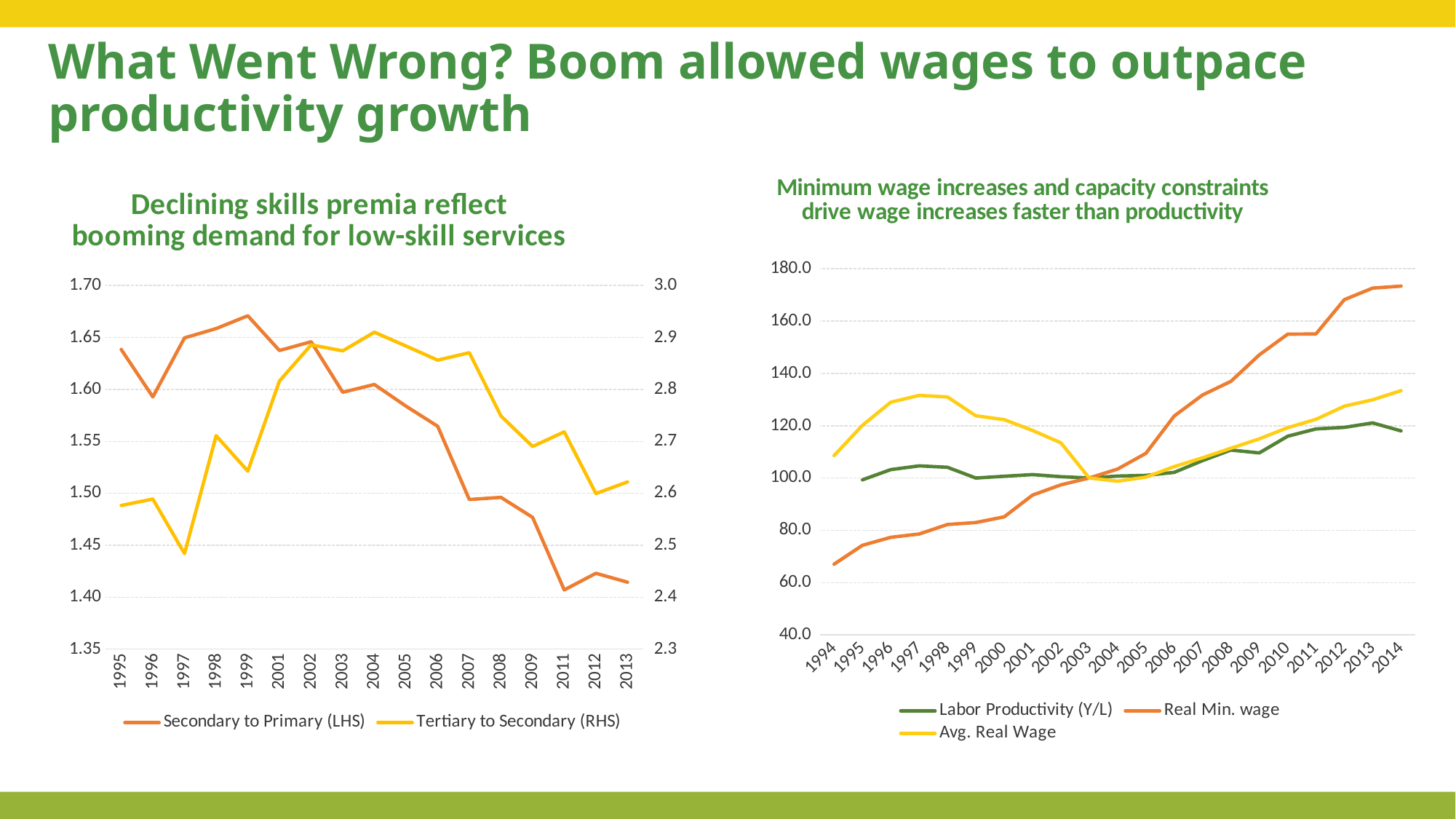
In the left chart, does the Secondary to Primary (LHS) series rise or fall overall from 1995 to 2013? Fall In the right chart, in which year is the Real Min. wage series at its lowest? 1994 In the left chart, is the value of Secondary to Primary (LHS) in 2011 greater or less than 1.45? less How many years are shown on the x axis of the right chart? 21 In the left chart, in which year is the Secondary to Primary (LHS) series at its highest? 1999 In the right chart, does the Real Min. wage series rise or fall overall from 1994 to 2014? Rise What kind of chart is the left chart titled 'Declining skills premia reflect booming demand for low-skill services'? Line chart How many series does the legend of the left chart list? 2 In the right chart, which series has the higher value in 2014: Real Min. wage or Labor Productivity (Y/L)? Real Min. wage In the right chart, is the value of Labor Productivity (Y/L) in 2014 greater or less than 120.0? less How many series does the legend of the right chart ('Minimum wage increases and capacity constraints drive wage increases faster than productivity') list? 3 In the right chart, is the value of Real Min. wage in 2014 greater or less than 160.0? greater